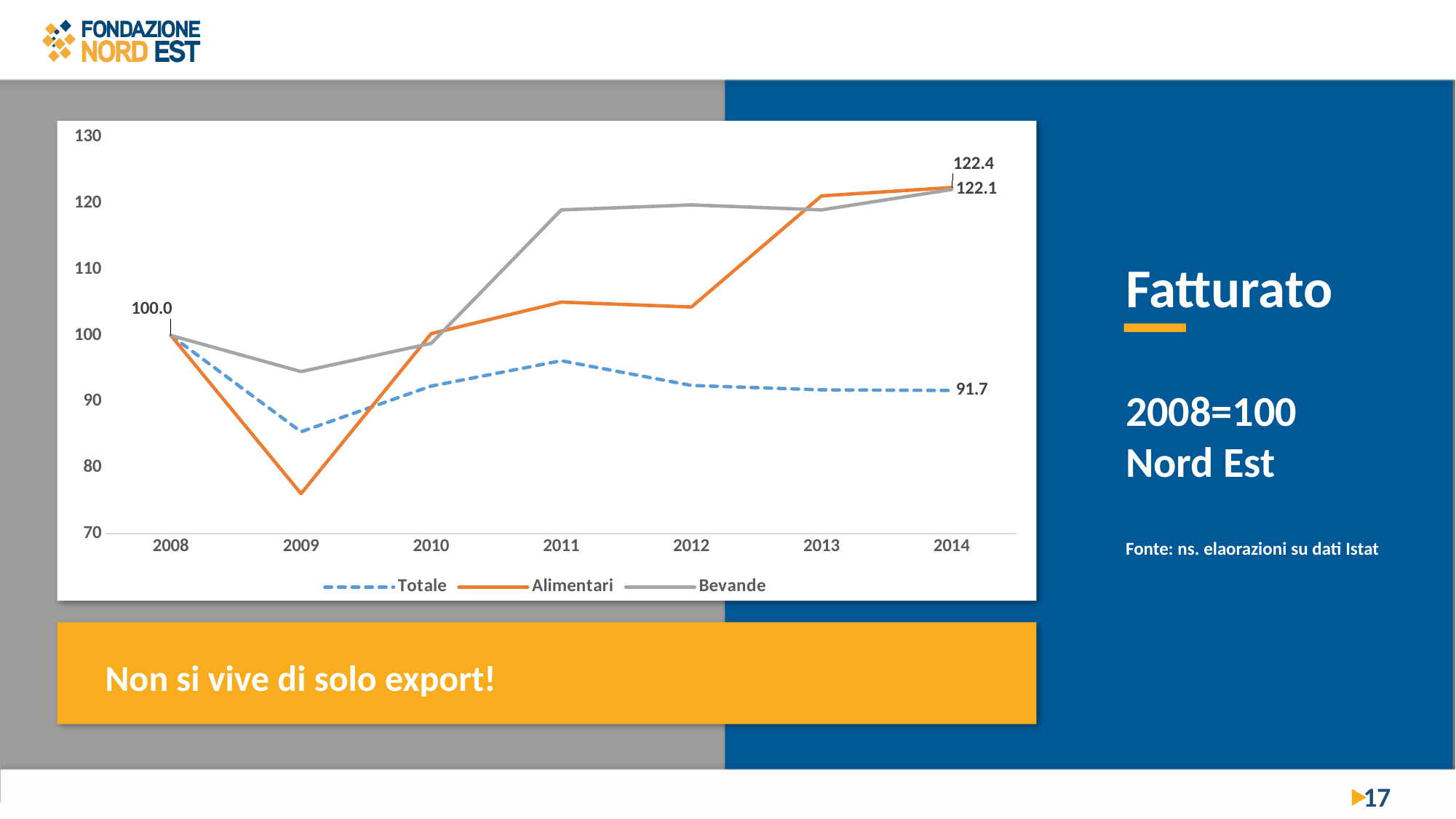
What kind of chart is shown on the slide? line chart How many series does the chart legend list? 3 Is the value for Totale in 2009 greater or less than 90? less In 2009, which series is higher: Bevande or Alimentari? Bevande Which series is drawn with a dashed line in the chart? Totale Is the value for Alimentari in 2009 greater or less than 80? less Is the value for Bevande in 2011 greater or less than 110? greater In which year does the Alimentari series reach its lowest value? 2009 What is the value of the Totale series in 2014? 91.7 How many years are shown on the x axis of the chart? 7 What is the value shown for 2008, the base year of the index? 100.0 By how much did the Totale series fall from 2008 (100.0) to 2014 (91.7)? 8.3